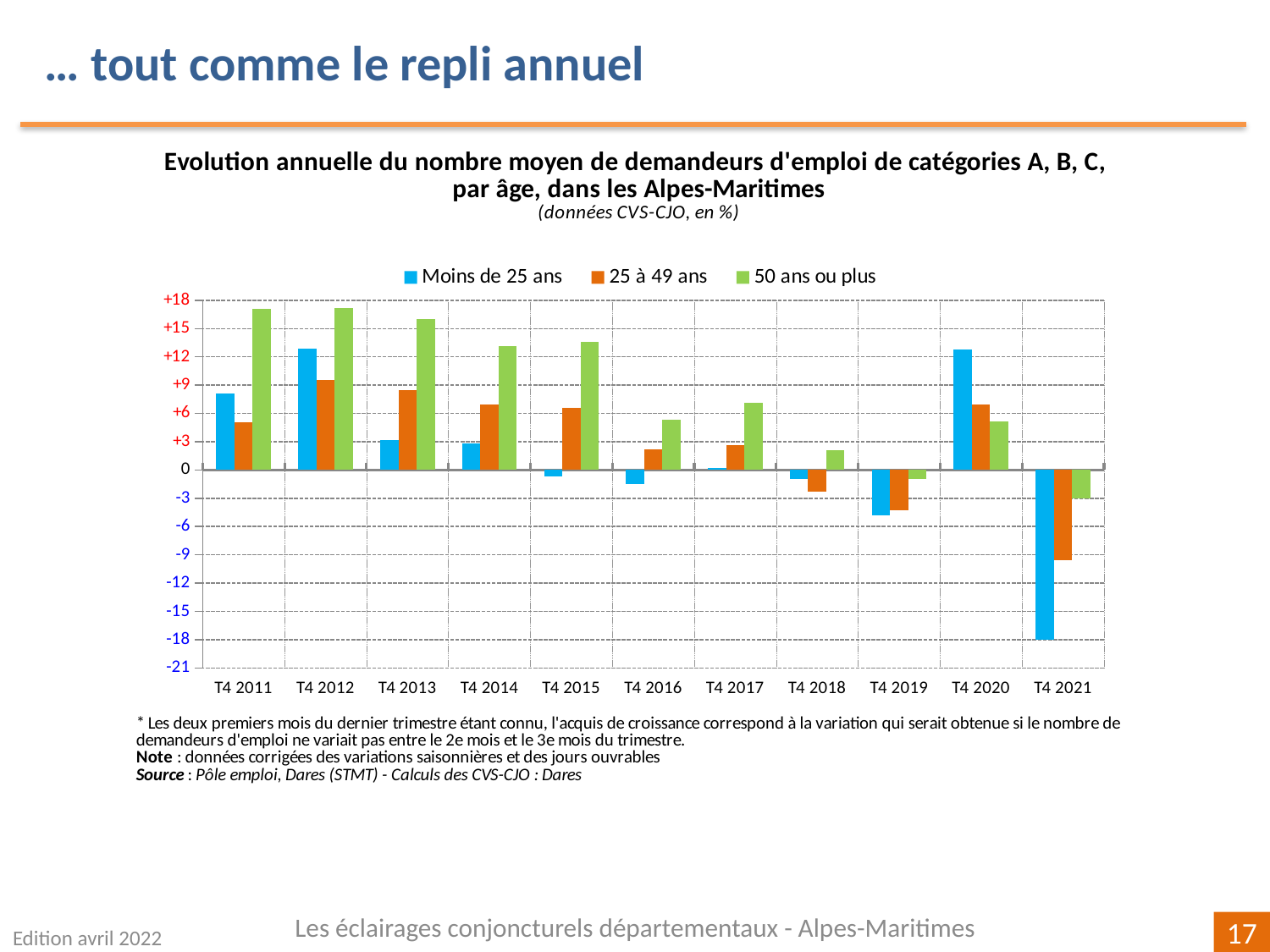
In T4 2015, which is larger: 'Moins de 25 ans' or '25 à 49 ans'? 25 à 49 ans Is the value for 'Moins de 25 ans' in T4 2021 greater or less than -15? less Is the value for '50 ans ou plus' in T4 2011 greater or less than +15? greater How many series does the legend list? 3 What kind of chart is shown on the slide? bar chart How many quarters (categories) are shown along the x axis? 11 Does the value for '50 ans ou plus' rise or fall from T4 2011 to T4 2019? fall In which quarter is the value for 'Moins de 25 ans' the lowest? T4 2021 In T4 2020, which is larger: 'Moins de 25 ans' or '50 ans ou plus'? Moins de 25 ans In which quarter is the value for '25 à 49 ans' the lowest? T4 2021 Is the value for '25 à 49 ans' in T4 2021 greater or less than -6? less